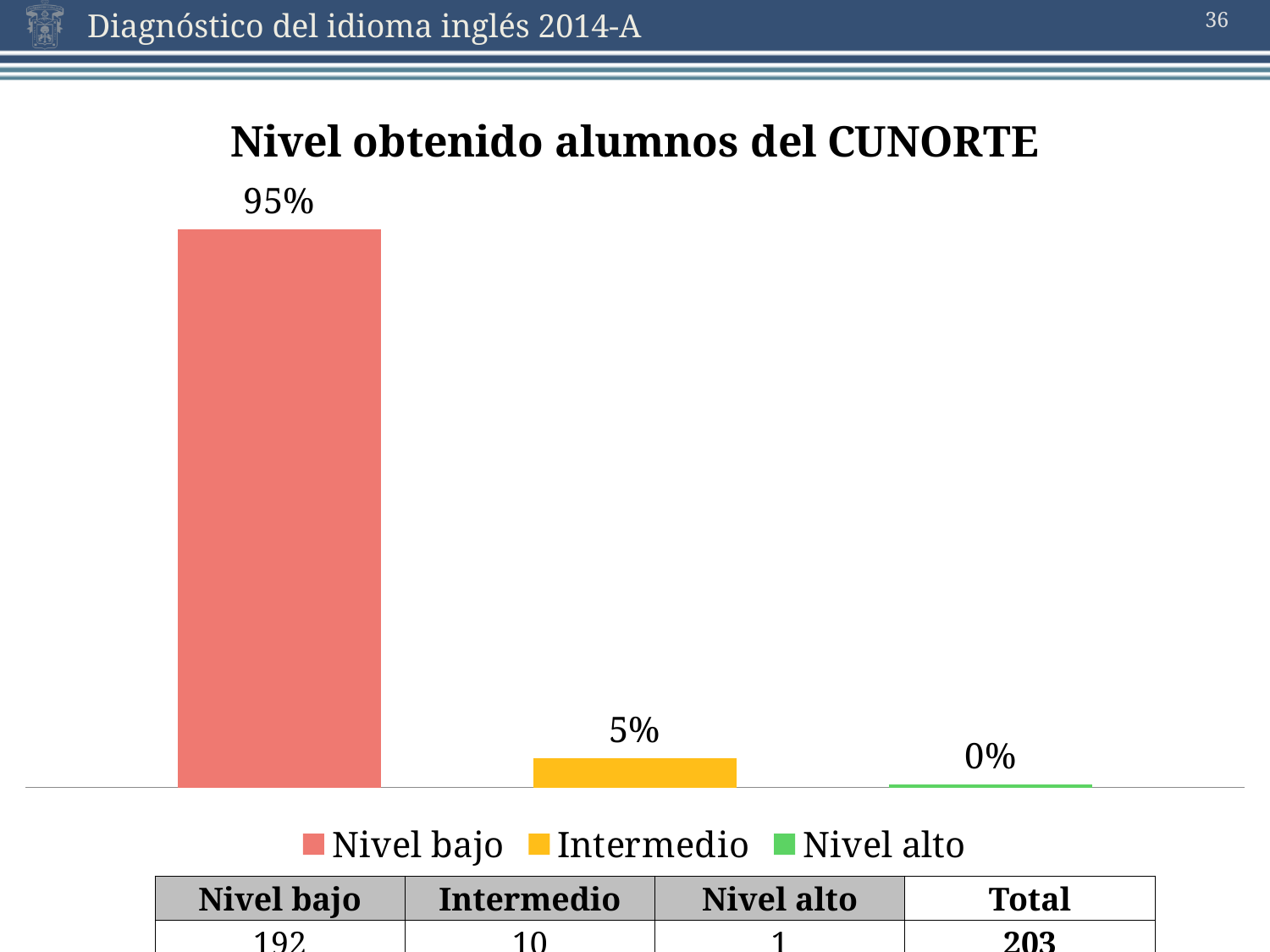
What is the title of the chart? Nivel obtenido alumnos del CUNORTE What is the value shown for Intermedio? 5% What is the value shown for Nivel alto? 0% What is the difference between the values for Nivel bajo and Intermedio? 90% How many entries does the legend list? 3 Do the values rise or fall from left to right across the categories? Fall Which is larger, the value for Intermedio or the value for Nivel alto? Intermedio Which category has the highest value? Nivel bajo Which category has the lowest value? Nivel alto What is the value shown for Nivel bajo? 95% What kind of chart is shown on the slide? Bar chart How many categories are plotted in the chart? 3